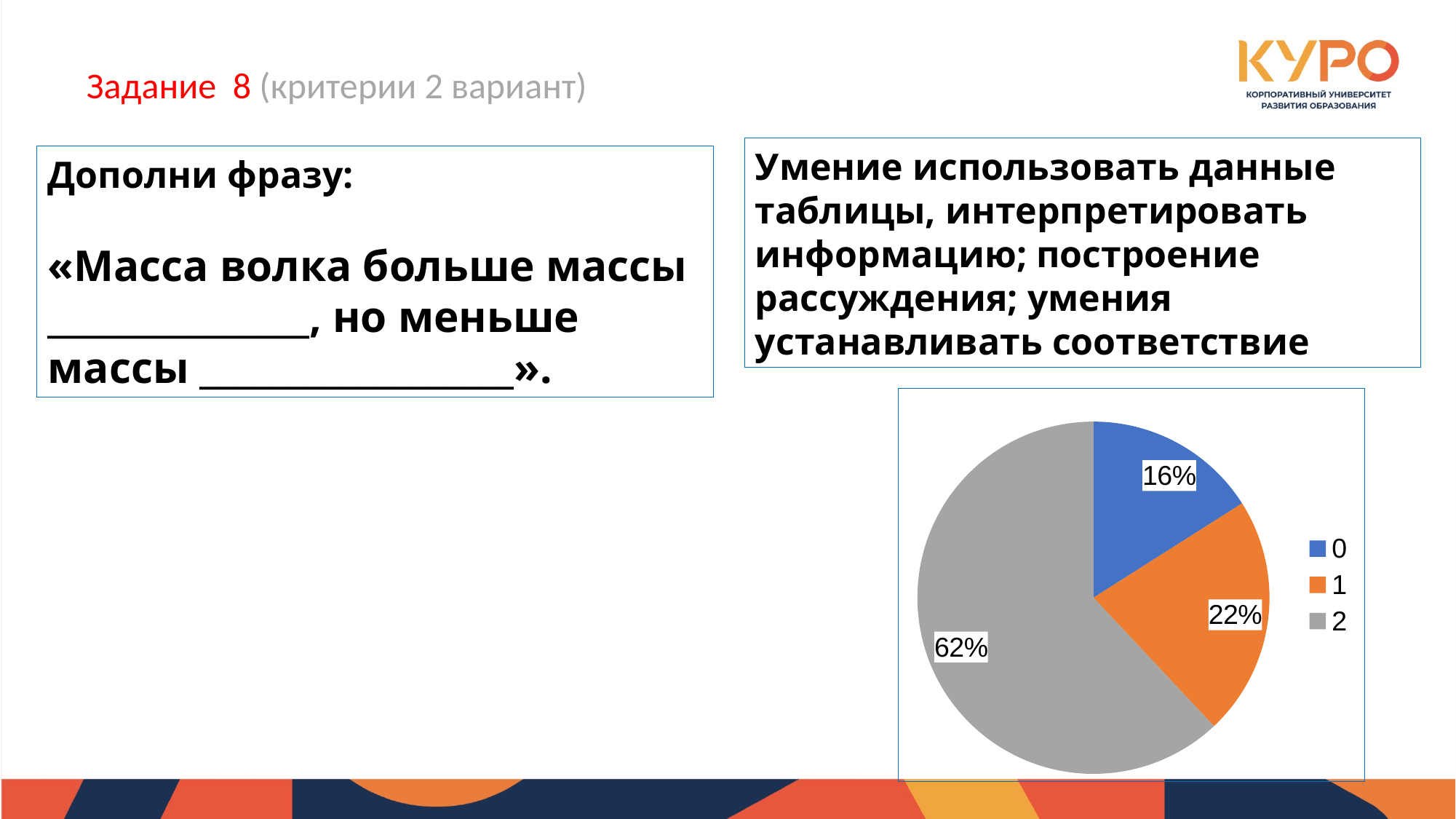
What is the difference in percentage points between category 2 and category 1? 40% What share of the pie does category 1 have? 22% Which is larger, the slice for category 1 or the slice for category 0? 1 How many entries does the legend list? 3 What share of the pie does category 2 have? 62% What is the difference in percentage points between category 1 and category 0? 6% Which category has the smallest slice of the pie? 0 What share of the pie does category 0 have? 16% What colour is the slice for category 2? grey What kind of chart is shown on the slide? pie chart Which category has the largest slice of the pie? 2 How many slices does the pie chart have? 3